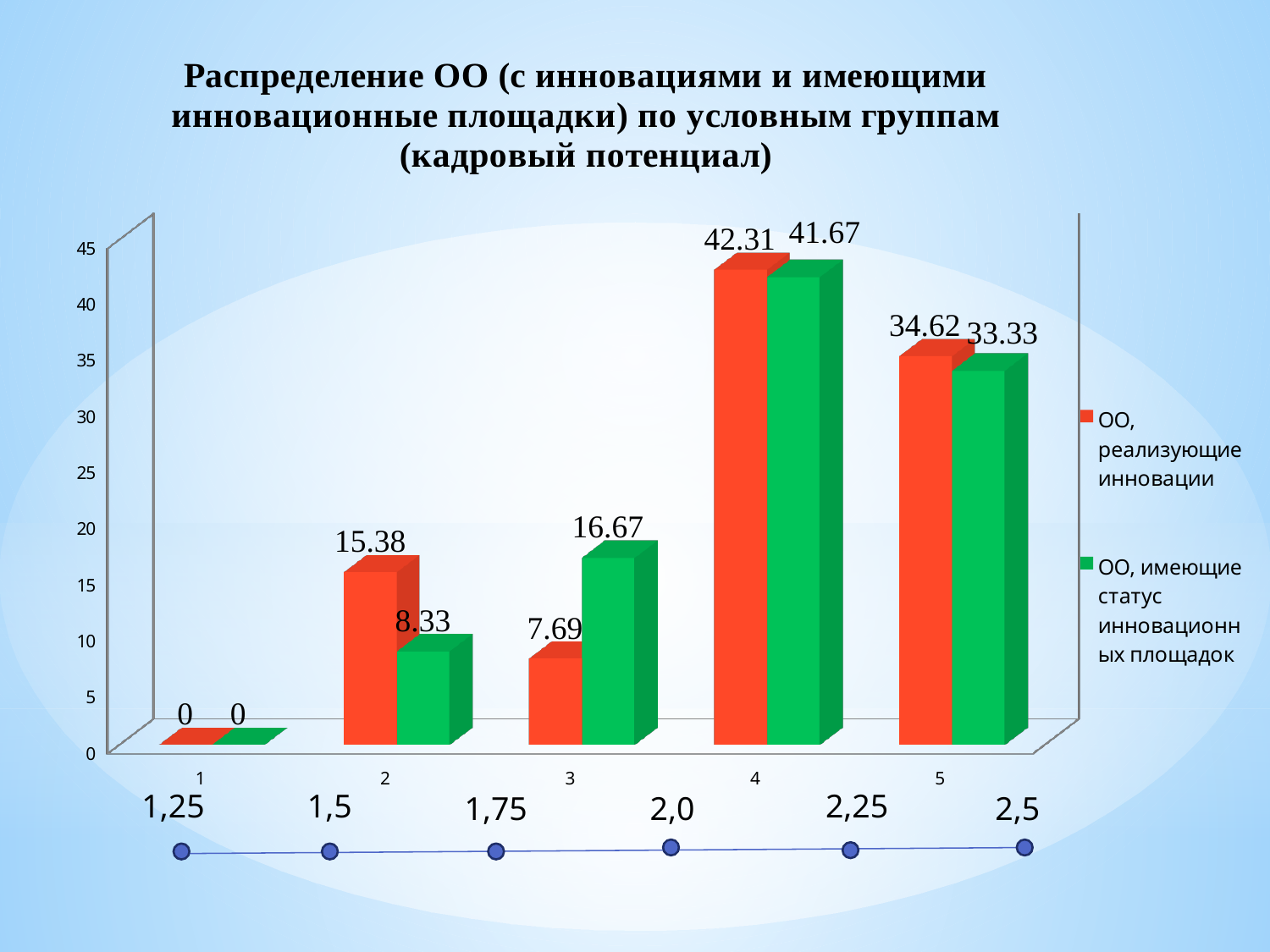
For category 3, which series has the larger value? ОО, имеющие статус инновационных площадок Which category has the highest value in the series "ОО, реализующие инновации"? 4 Which category has the lowest value in the series "ОО, имеющие статус инновационных площадок"? 1 What type of chart is shown on the slide? Bar chart How many categories are shown on the x axis of the chart? 5 What is the value for category 3 in the series "ОО, имеющие статус инновационных площадок"? 16.67 How many series does the legend list? 2 What is the value for category 2 in the series "ОО, реализующие инновации"? 15.38 Which colour represents the series "ОО, реализующие инновации"? Red What is the difference between the two series' values for category 2? 7.05 Is the value for category 5 in the series "ОО, реализующие инновации" greater or less than 30? greater What is the value for category 4 in the series "ОО, реализующие инновации"? 42.31